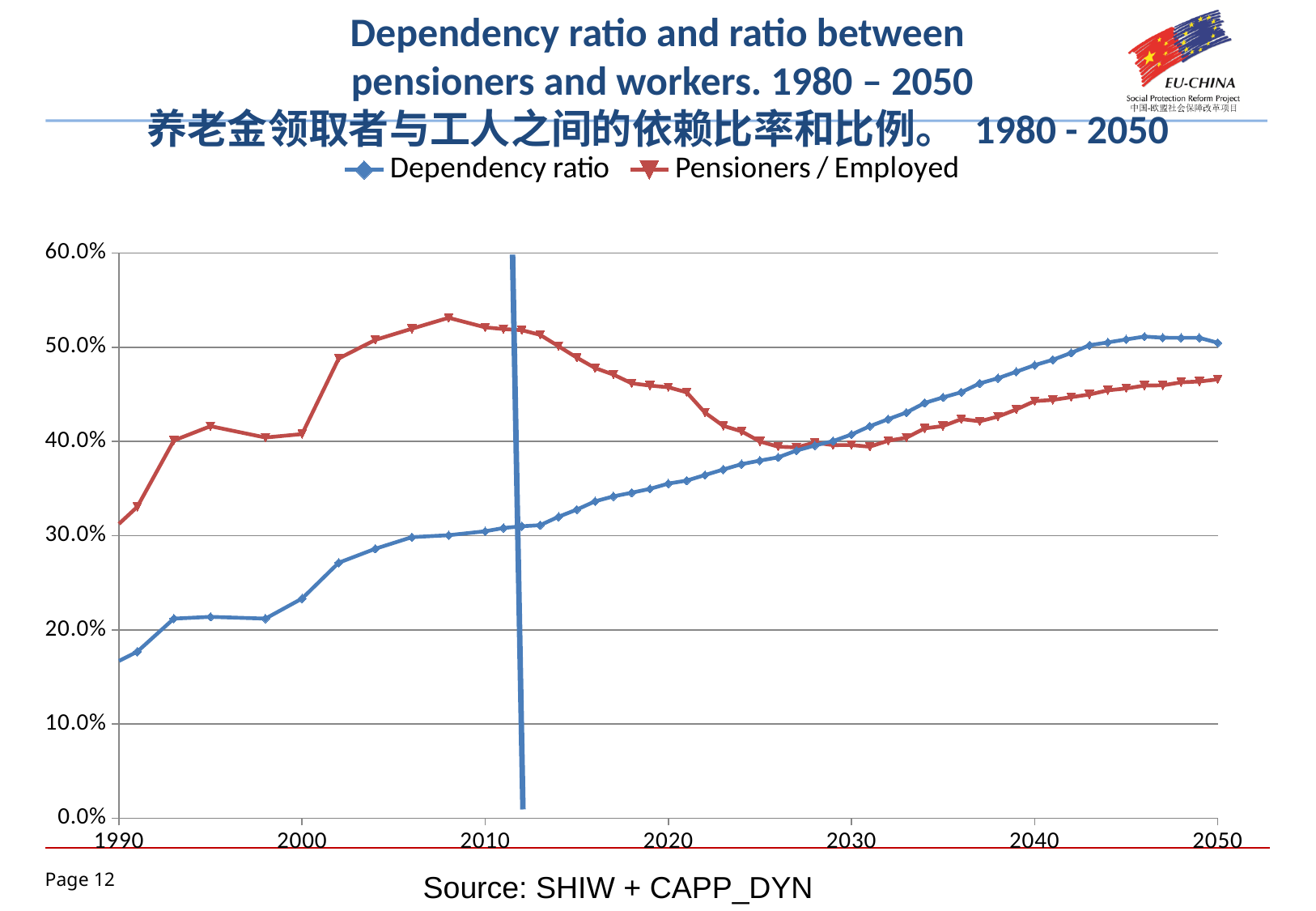
In 2050, which series has the higher value, Dependency ratio or Pensioners / Employed? Dependency ratio What source is cited below the chart? SHIW + CAPP_DYN Is the Pensioners / Employed value in 1990 greater or less than 40.0%? less Is the Dependency ratio value in 2050 greater or less than 40.0%? greater Is the Dependency ratio value in 1990 greater or less than 20.0%? less In 2000, which series has the higher value, Dependency ratio or Pensioners / Employed? Pensioners / Employed What kind of chart is shown on the slide? line chart How many series does the legend list? 2 What are the two series named in the legend? Dependency ratio and Pensioners / Employed Does the Dependency ratio series generally rise or fall from 1990 to 2050? rise